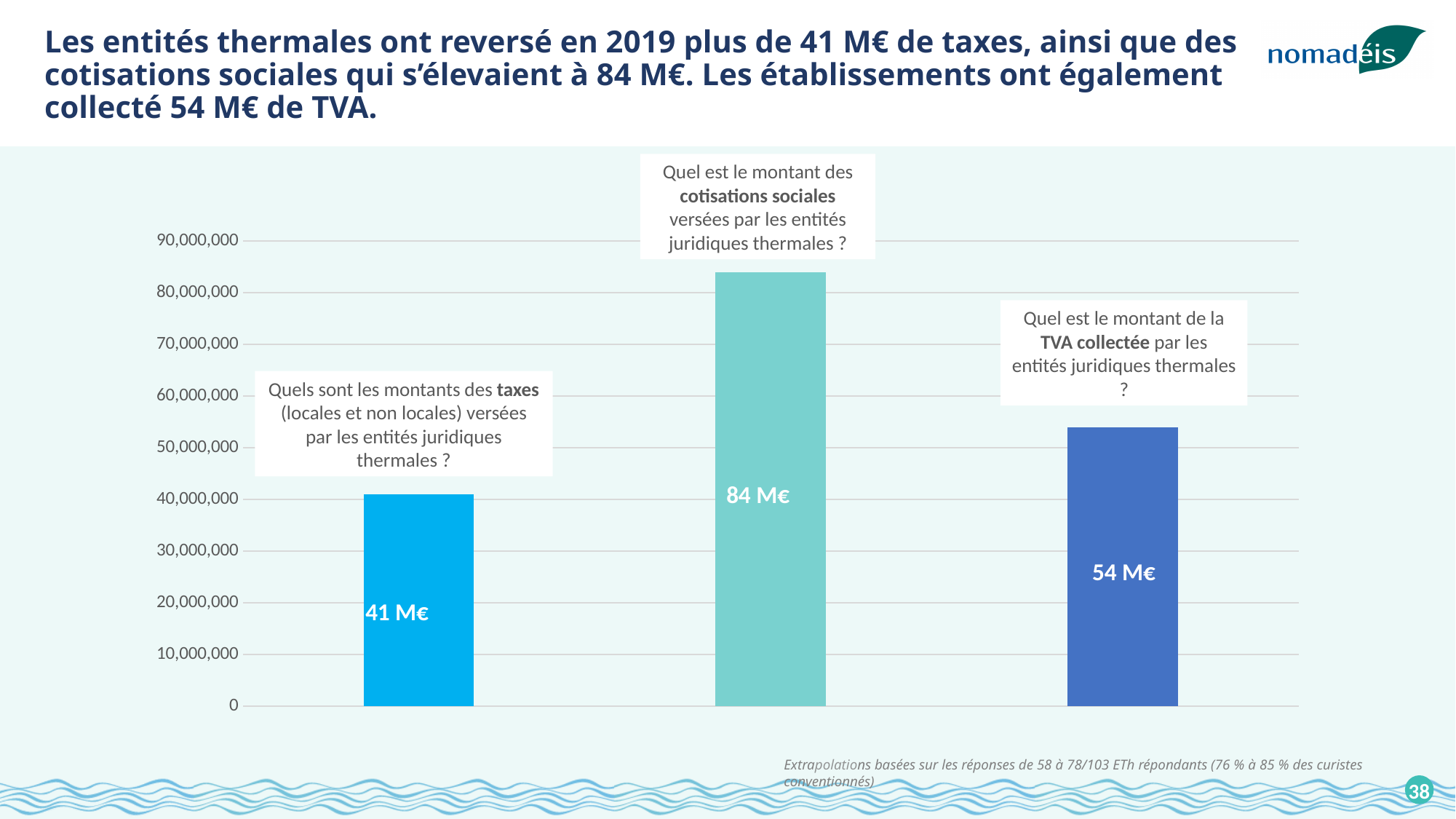
What is the difference between the TVA collectée bar and the taxes bar? 13 M€ What kind of chart is shown on the slide? bar chart What is the difference between the cotisations sociales bar and the taxes bar? 43 M€ What is the highest value shown on the vertical axis? 90,000,000 What is the value of the bar for taxes (locales et non locales) versées par les entités juridiques thermales? 41 M€ How many bars are plotted in the chart? 3 Which bar has the highest value? cotisations sociales What is the value of the bar for TVA collectée par les entités juridiques thermales? 54 M€ Which bar has the lowest value? taxes (locales et non locales) What is the value of the bar for cotisations sociales versées par les entités juridiques thermales? 84 M€ Which is larger, the TVA collectée bar or the taxes bar? TVA collectée Is the value for cotisations sociales greater or less than 80,000,000? greater